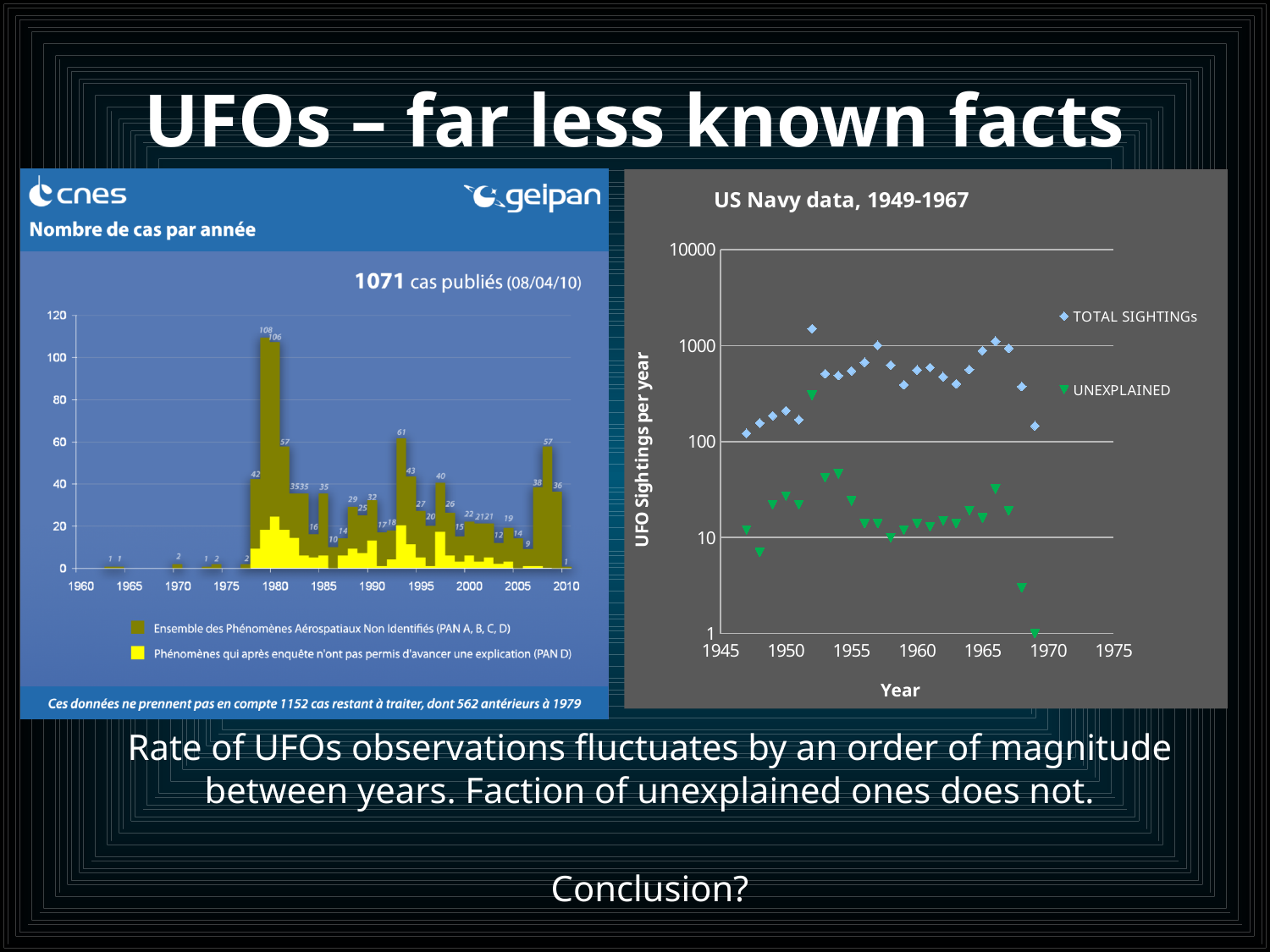
What is the y-axis label of the "US Navy data, 1949-1967" chart? UFO Sightings per year In the "US Navy data, 1949-1967" chart, is the UNEXPLAINED value for 1968 greater or less than 10? less How many series does the legend of the "US Navy data, 1949-1967" chart list? 2 In the "US Navy data, 1949-1967" chart, is the TOTAL SIGHTINGs value for 1952 greater or less than 1000? greater How many series does the legend of the left-hand chart "Nombre de cas par année" list? 2 In the left-hand chart "Nombre de cas par année", what is the highest value labelled on a bar? 108 In the "US Navy data, 1949-1967" chart, which series has the higher value in 1957, TOTAL SIGHTINGs or UNEXPLAINED? TOTAL SIGHTINGs According to the left-hand chart "Nombre de cas par année", how many cases were published (cas publiés) as of 08/04/10? 1071 What kind of chart is the left-hand chart titled "Nombre de cas par année"? bar chart What kind of chart is the right-hand chart titled "US Navy data, 1949-1967"? scatter chart In the "US Navy data, 1949-1967" chart, is the UNEXPLAINED value for 1953 greater or less than 100? less What are the two series named in the legend of the "US Navy data, 1949-1967" chart? TOTAL SIGHTINGs and UNEXPLAINED